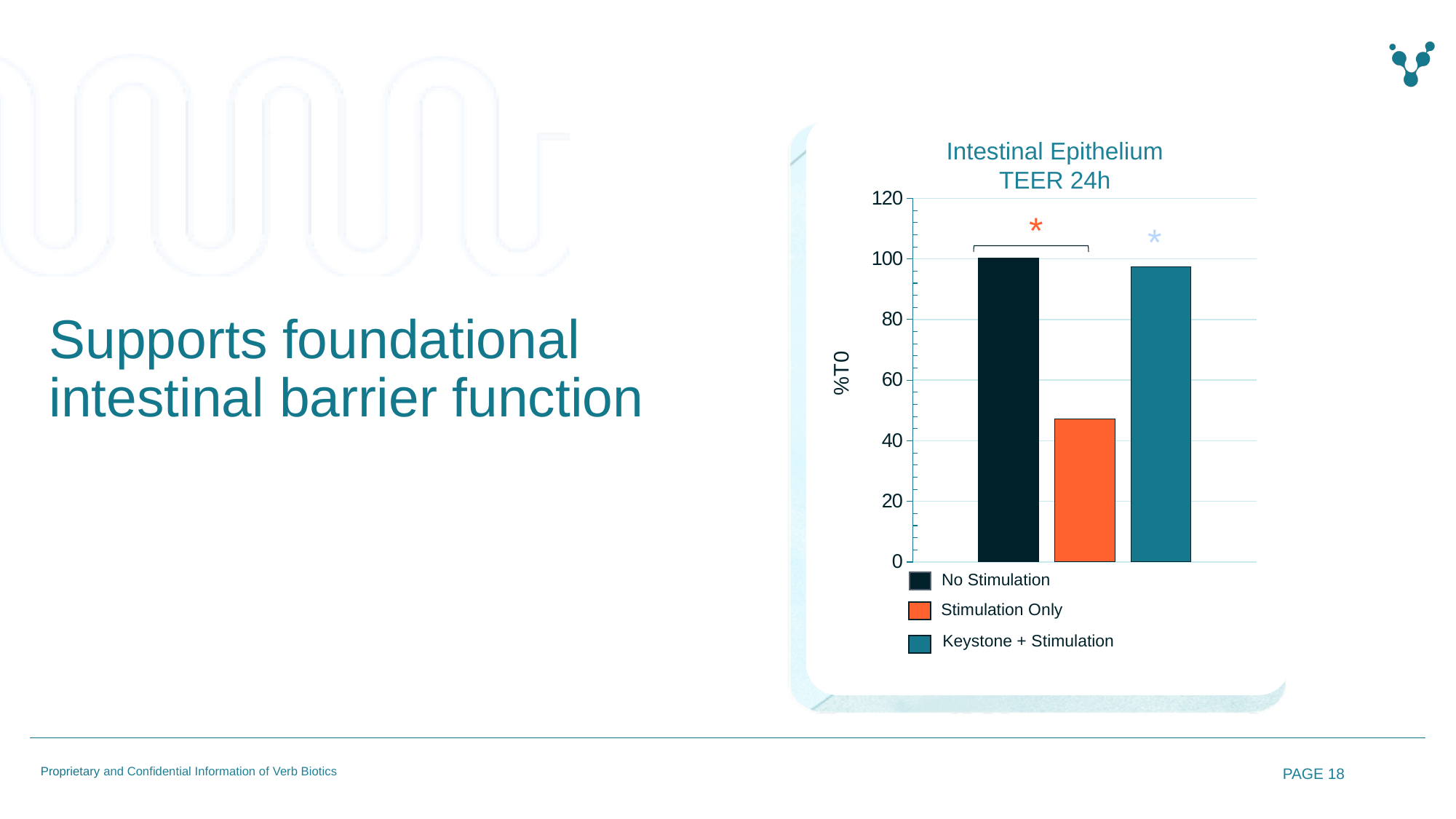
How many bars are plotted in the Intestinal Epithelium TEER 24h chart? 3 Which condition has the lowest %T0 value in the chart? Stimulation Only Is the value for Stimulation Only greater or less than 40? greater Is the value for Keystone + Stimulation greater or less than 80? greater What is the title of the chart? Intestinal Epithelium TEER 24h Which is larger, the value for Stimulation Only or the value for Keystone + Stimulation? Keystone + Stimulation What kind of chart is shown on the slide? bar chart How many entries does the legend of the chart list? 3 What is the label on the y axis of the chart? %T0 Is the value for Stimulation Only greater or less than 60? less